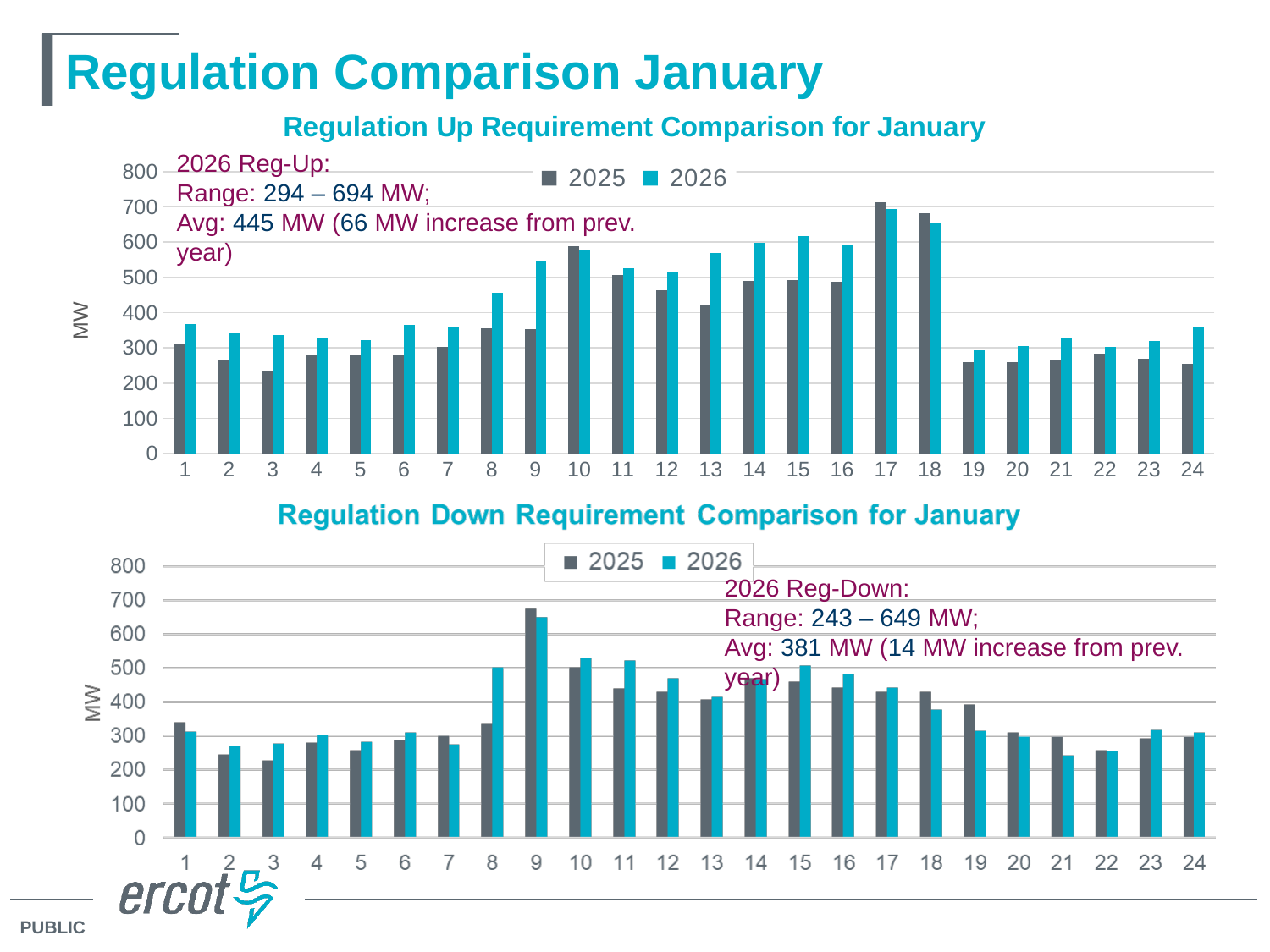
In the 'Regulation Up Requirement Comparison for January' chart, is the 2026 value at hour 9 greater or less than 500? greater How many hour categories are shown on the x axis of the 'Regulation Up Requirement Comparison for January' chart? 24 In the 'Regulation Down Requirement Comparison for January' chart, at hour 18, which series has the larger value, 2025 or 2026? 2025 In the 'Regulation Down Requirement Comparison for January' chart, at which hour is the 2025 value highest? 9 According to the annotation on the 'Regulation Up Requirement Comparison for January' chart, what is the 2026 Reg-Up average in MW? 445 MW In the 'Regulation Down Requirement Comparison for January' chart, at which hour is the 2026 value lowest? 21 In the 'Regulation Up Requirement Comparison for January' chart, at hour 8, which series has the larger value, 2025 or 2026? 2026 In the 'Regulation Up Requirement Comparison for January' chart, at which hour is the 2026 value highest? 17 What type of chart is the 'Regulation Up Requirement Comparison for January' chart? bar chart In the 'Regulation Down Requirement Comparison for January' chart, do the 2026 values rise or fall from hour 17 to hour 21? fall How many series does the legend list in the 'Regulation Down Requirement Comparison for January' chart? 2 In the 'Regulation Up Requirement Comparison for January' chart, is the 2025 value at hour 3 greater or less than 300? less